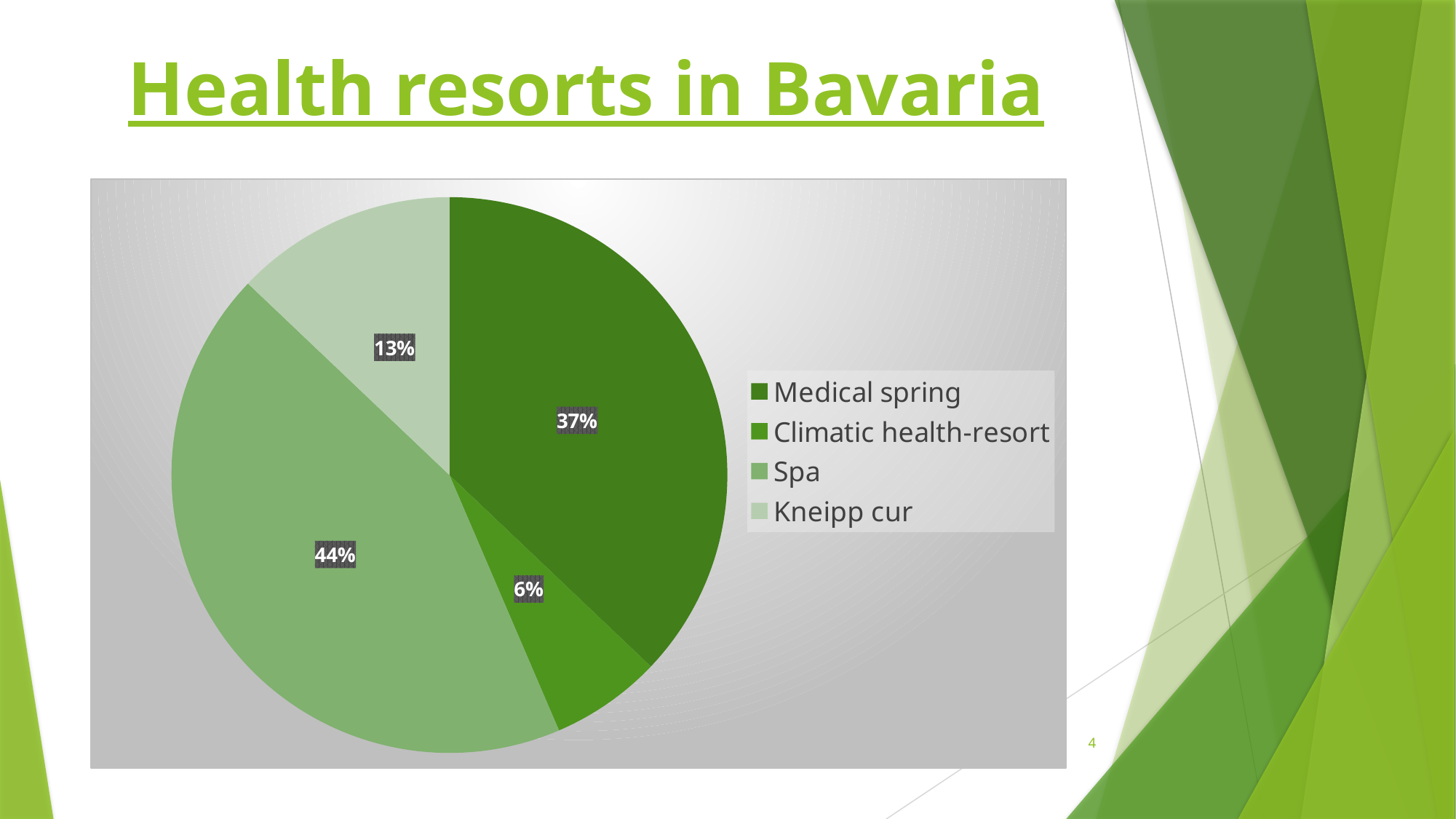
Which is larger, the share for Kneipp cur or the share for Climatic health-resort? Kneipp cur What share of the pie does Climatic health-resort have? 6% What is the difference between the shares of Spa and Medical spring? 7% Which category has the largest slice of the pie? Spa What share of the pie does Kneipp cur have? 13% Which category has the smallest slice of the pie? Climatic health-resort How many categories does the pie chart have? 4 What share of the pie does Medical spring have? 37% What kind of chart is shown on the slide? pie chart What is the title of the slide containing the chart? Health resorts in Bavaria Which legend entry is listed first? Medical spring